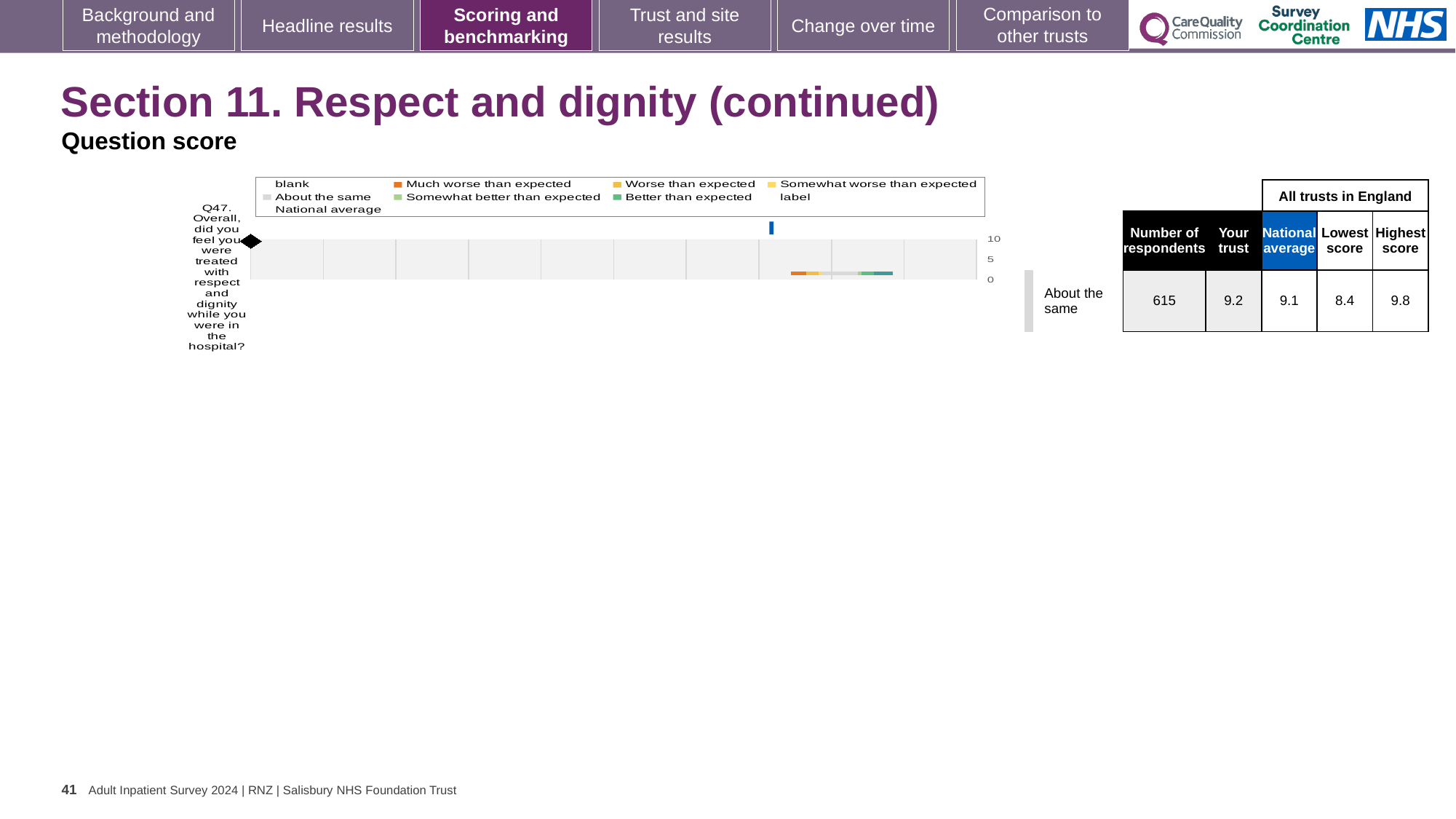
What is the National average score for Q47? 9.1 What is the last entry listed in the chart legend? National average What is the difference between Your trust score and the National average for Q47? 0.1 What is the highest value shown on the chart's score axis? 10 Which benchmark category is Q47 placed in? About the same Which is larger for Q47, Your trust score or the National average? Your trust What kind of chart is shown on the slide? bar chart What is the Lowest score among all trusts in England for Q47? 8.4 What is the score for Your trust for Q47? 9.2 How many respondents answered Q47? 615 What is the Highest score among all trusts in England for Q47? 9.8 What is the difference between the Highest score and the Lowest score for Q47? 1.4